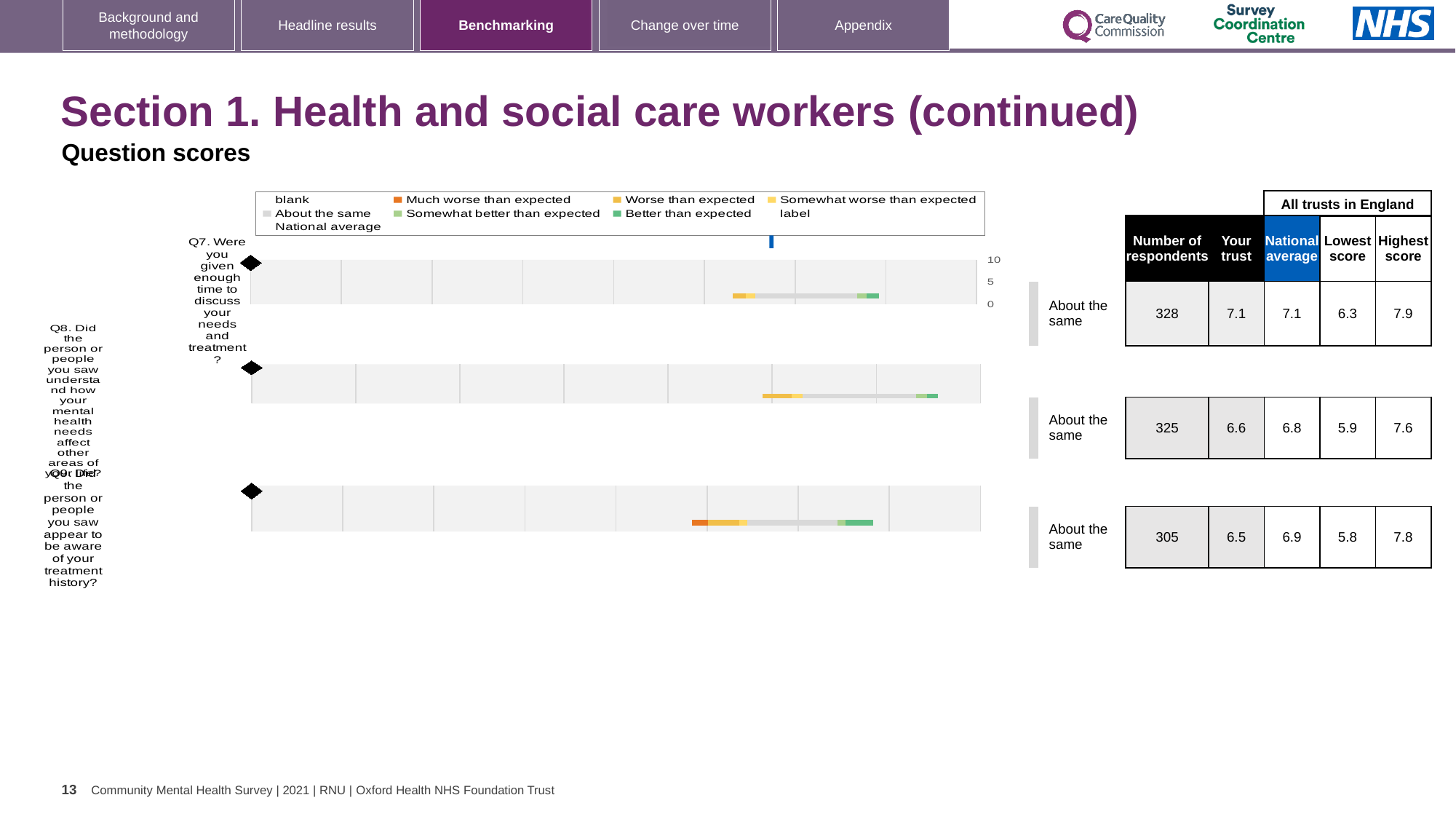
What is the difference between the national average and the 'Your trust' score for Q9? 0.4 Which question has the highest 'Your trust' score on this slide? Q7 For Q8, which is larger: the 'Your trust' score or the national average? National average What is the highest score among all trusts in England for Q7? 7.9 How many respondents are shown for Q7 (Were you given enough time to discuss your needs and treatment?)? 328 What benchmark category is shown for Q9? About the same What is the national average score for Q8 (Did the person or people you saw understand how your mental health needs affect other areas of your life?)? 6.8 What kind of chart is used to show the question scores on this slide? Bar chart How many questions are charted on this slide? 3 Which question has the lowest 'Your trust' score on this slide? Q9 What is the lowest score among all trusts in England for Q9 (Did the person or people you saw appear to be aware of your treatment history?)? 5.8 What is the 'Your trust' score for Q7? 7.1